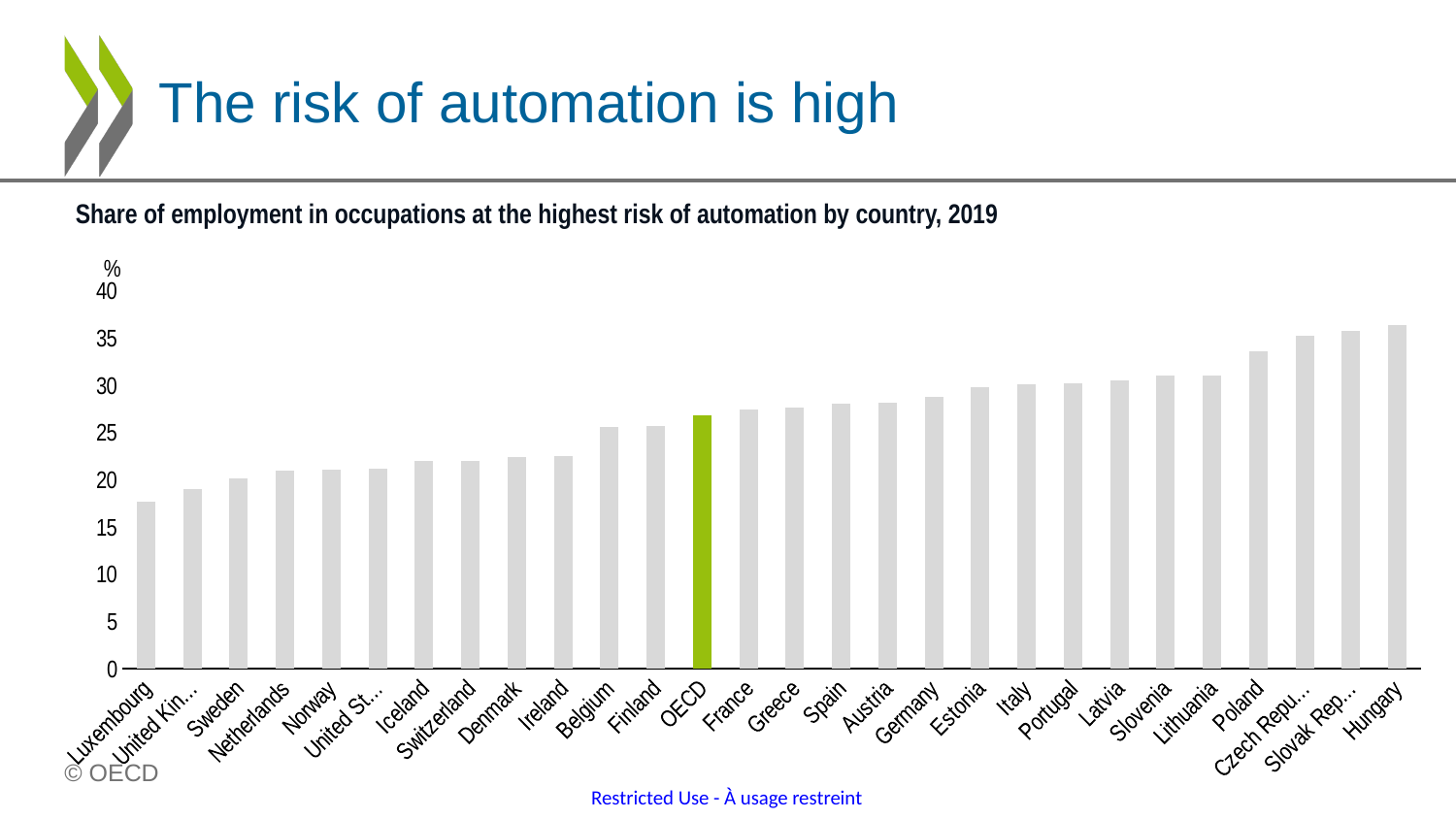
Do the bar values rise or fall from left to right along the x axis? rise Is the value for Hungary greater or less than 35? greater Is the value for Ireland greater or less than 25? less Which bar is highlighted in green rather than grey? OECD Is the value for Poland greater or less than 30? greater Which country has the lowest share of employment in occupations at the highest risk of automation? Luxembourg What kind of chart is shown on the slide? bar chart Which country has the highest share of employment in occupations at the highest risk of automation? Hungary How many bars are plotted in the chart? 28 Which has a higher value, Poland or Ireland? Poland